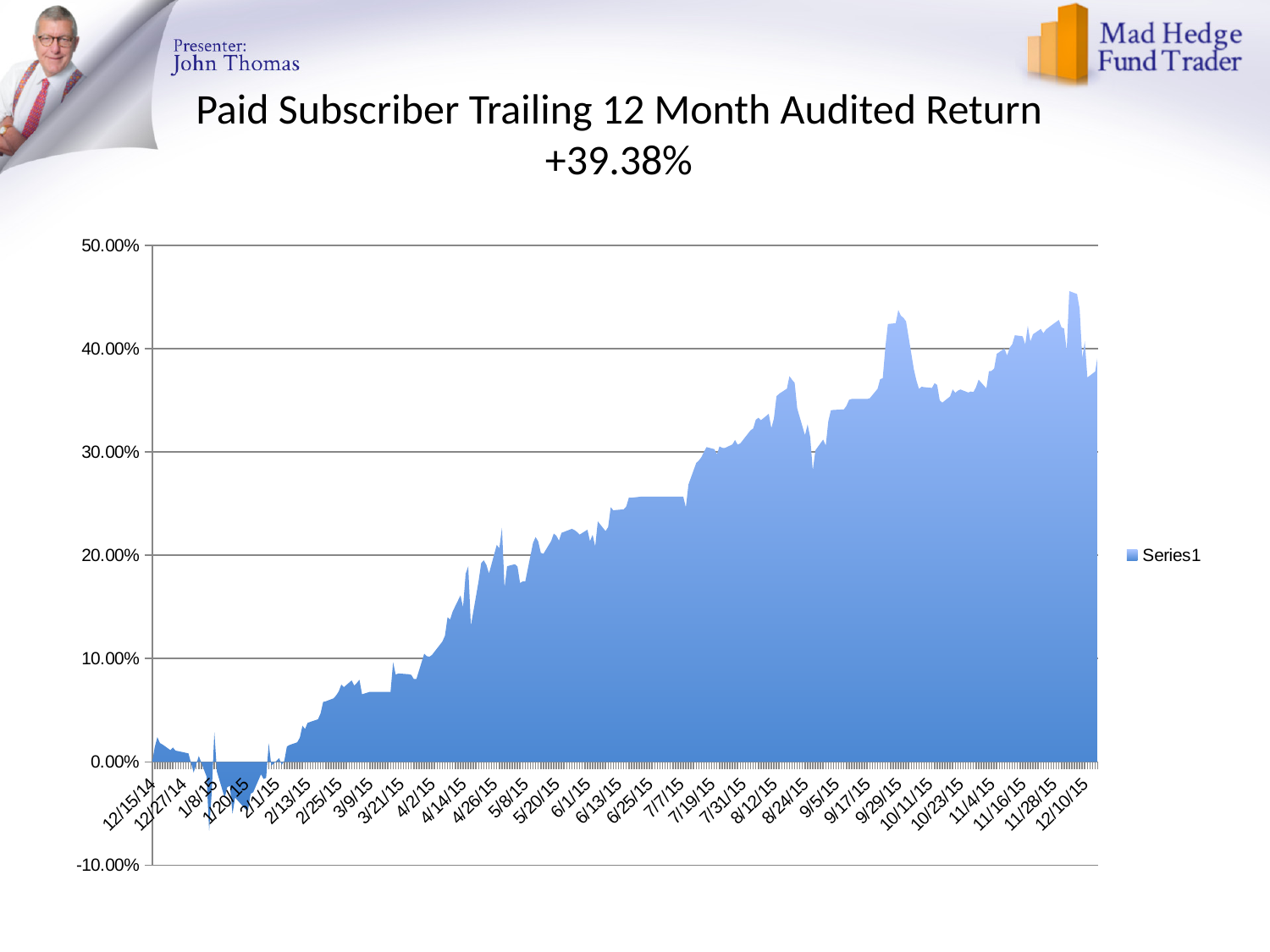
How many series does the legend list? 1 What is the name of the series shown in the legend? Series1 What trailing 12 month audited return is stated in the chart title? +39.38% Is the value around 6/1/15 greater or less than 30.00%? less Is the value around 7/7/15 greater or less than 20.00%? greater Which is larger, the value around 8/12/15 or the value around 4/2/15? 8/12/15 Is the value around 1/20/15 greater or less than 0.00%? less Do the values generally rise or fall from 12/15/14 to 12/10/15? rise What kind of chart is shown on the slide? area chart